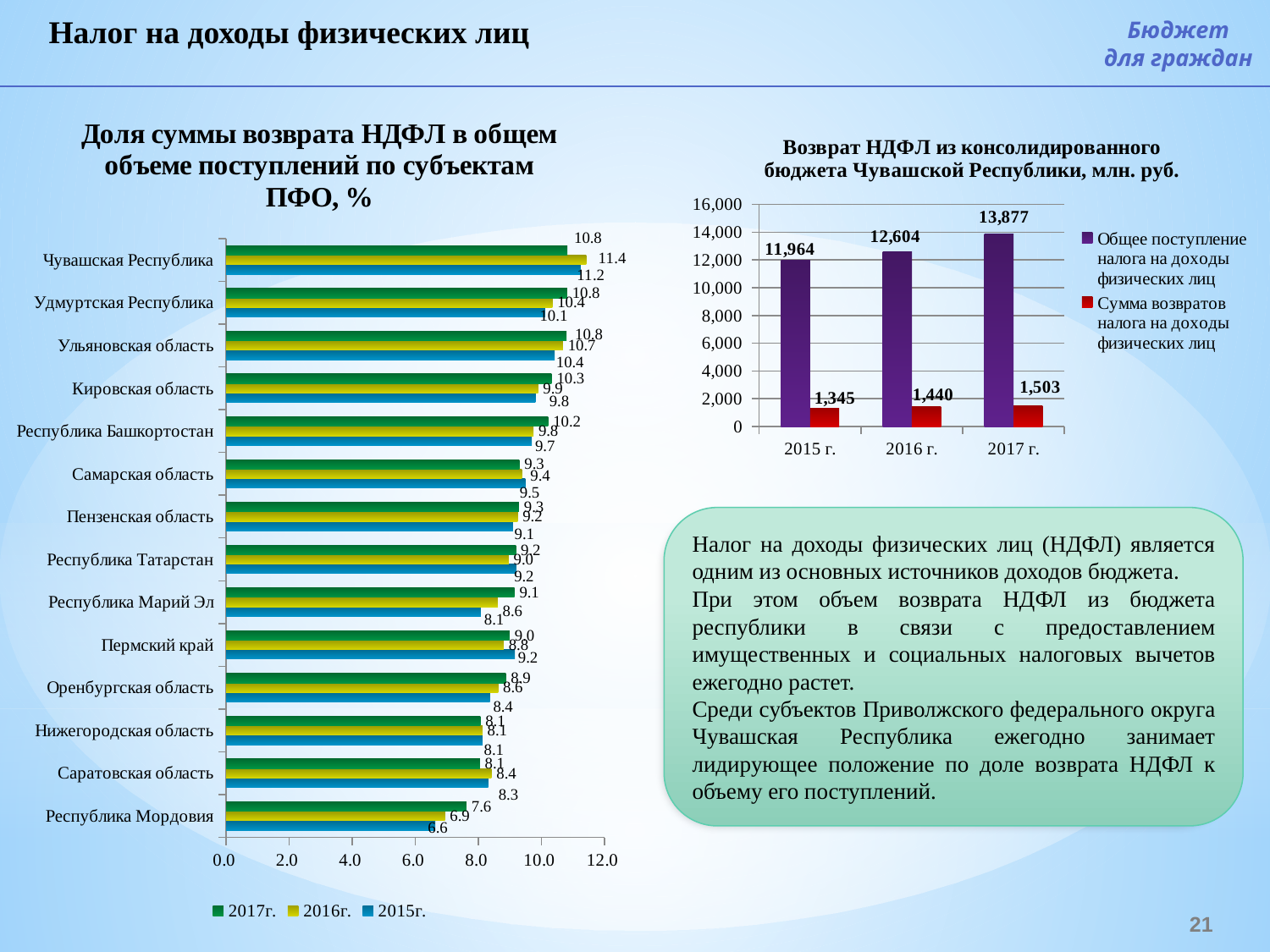
On the chart 'Возврат НДФЛ из консолидированного бюджета Чувашской Республики, млн. руб.', how many years are shown on the x axis? 3 On the chart 'Доля суммы возврата НДФЛ в общем объеме поступлений по субъектам ПФО, %', how many regions are listed? 14 On the chart 'Возврат НДФЛ из консолидированного бюджета Чувашской Республики, млн. руб.', do the values of 'Сумма возвратов налога на доходы физических лиц' rise or fall from 2015 г. to 2017 г.? rise What kind of chart is 'Доля суммы возврата НДФЛ в общем объеме поступлений по субъектам ПФО, %'? bar chart On the chart 'Возврат НДФЛ из консолидированного бюджета Чувашской Республики, млн. руб.', how many series does the legend list? 2 On the chart 'Возврат НДФЛ из консолидированного бюджета Чувашской Республики, млн. руб.', what is the value of 'Общее поступление налога на доходы физических лиц' for 2017 г.? 13,877 On the chart 'Возврат НДФЛ из консолидированного бюджета Чувашской Республики, млн. руб.', what is the difference between the two series in 2017 г.? 12,374 On the chart 'Доля суммы возврата НДФЛ в общем объеме поступлений по субъектам ПФО, %', what is the value for Чувашская Республика in 2016г.? 11.4 On the chart 'Доля суммы возврата НДФЛ в общем объеме поступлений по субъектам ПФО, %', what is the value for Республика Мордовия in 2015г.? 6.6 On the chart 'Доля суммы возврата НДФЛ в общем объеме поступлений по субъектам ПФО, %', how many series does the legend list? 3 On the chart 'Возврат НДФЛ из консолидированного бюджета Чувашской Республики, млн. руб.', what is the value of 'Сумма возвратов налога на доходы физических лиц' for 2015 г.? 1,345 On the chart 'Доля суммы возврата НДФЛ в общем объеме поступлений по субъектам ПФО, %', which region has the lowest value in 2017г.? Республика Мордовия